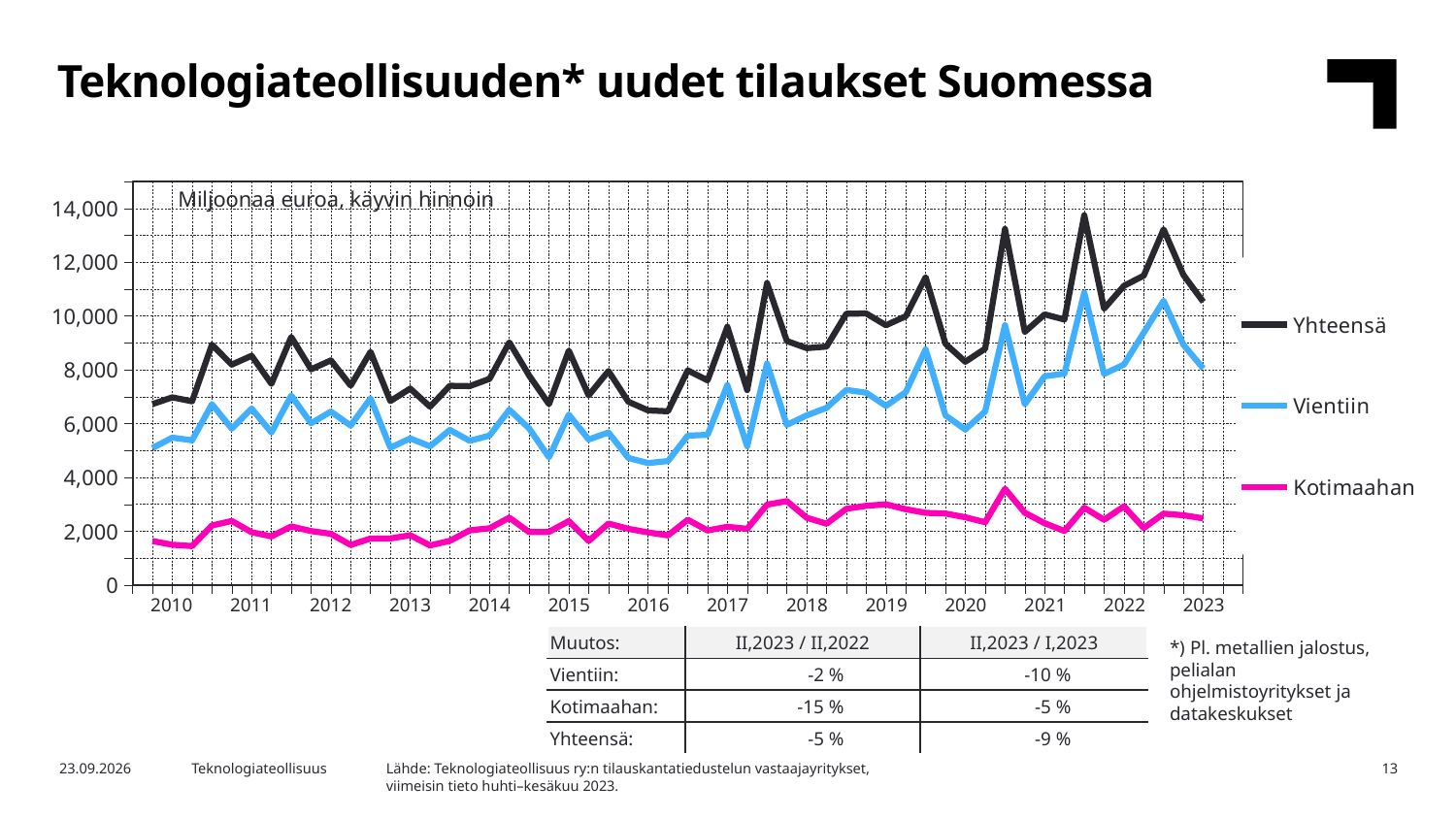
Is the first value of the Vientiin series in 2010 greater or less than 6,000? less What are the three series named in the chart legend? Yhteensä, Vientiin, Kotimaahan Does the Yhteensä series overall rise or fall from 2010 to 2023? rise How many series does the chart legend list? 3 Which series has the highest values throughout the chart? Yhteensä Which series has the lowest values throughout the chart? Kotimaahan Is the last value of the Yhteensä series in 2023 greater or less than 10,000? greater Which series is larger in 2018, Vientiin or Kotimaahan? Vientiin Is the highest value of the Kotimaahan series greater or less than 4,000? less What unit label is printed inside the chart area? Miljoonaa euroa, käyvin hinnoin What kind of chart is shown on the slide? line chart